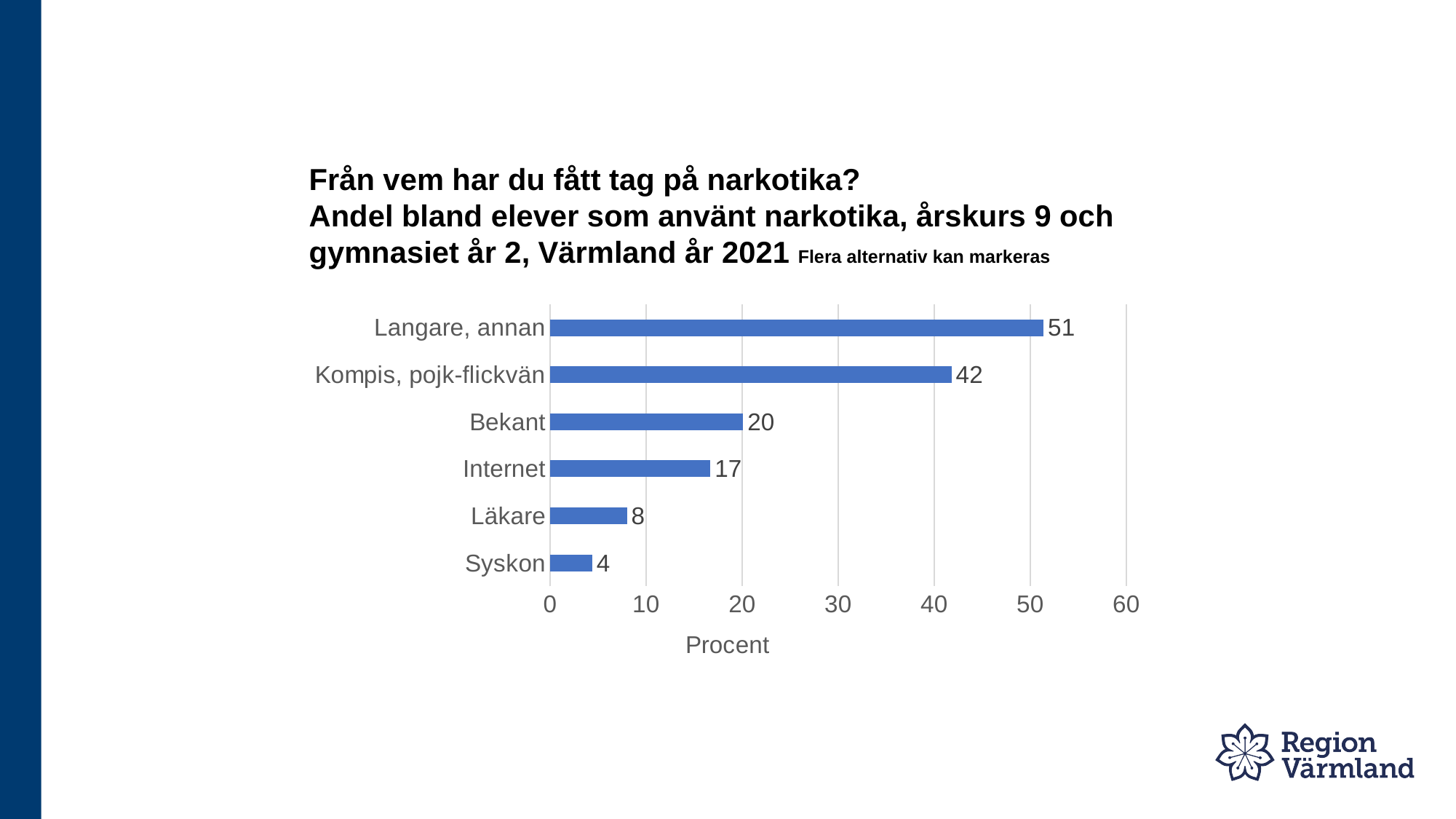
What is the value for "Internet"? 17 Which category has the highest value? Langare, annan What kind of chart is shown on the slide? bar chart What is the difference between the values for "Bekant" and "Internet"? 3 What is the label of the horizontal axis? Procent Is the value for "Kompis, pojk-flickvän" greater or less than 40? greater What is the value for "Läkare"? 8 What is the difference between the values for "Langare, annan" and "Kompis, pojk-flickvän"? 9 Which has a larger value, "Bekant" or "Läkare"? Bekant How many categories are shown in the chart? 6 What is the value for "Langare, annan"? 51 Which category has the lowest value? Syskon